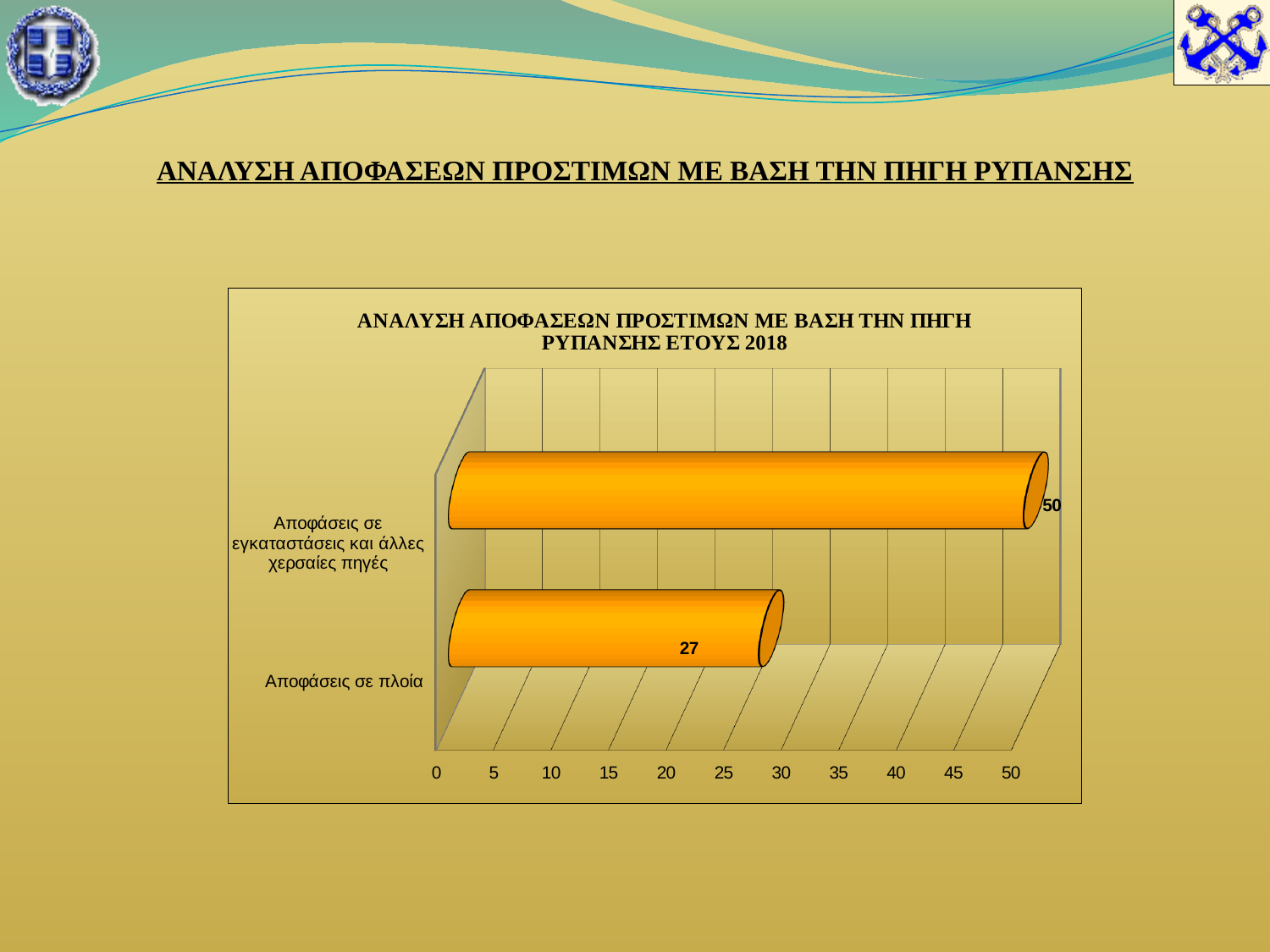
What is the title of the chart? ΑΝΑΛΥΣΗ ΑΠΟΦΑΣΕΩΝ ΠΡΟΣΤΙΜΩΝ ΜΕ ΒΑΣΗ ΤΗΝ ΠΗΓΗ ΡΥΠΑΝΣΗΣ ΕΤΟΥΣ 2018 Which category has the lowest value? Αποφάσεις σε πλοία What is the difference between the value for Αποφάσεις σε εγκαταστάσεις και άλλες χερσαίες πηγές and the value for Αποφάσεις σε πλοία? 23 Which is larger: the value for Αποφάσεις σε πλοία or the value for Αποφάσεις σε εγκαταστάσεις και άλλες χερσαίες πηγές? Αποφάσεις σε εγκαταστάσεις και άλλες χερσαίες πηγές Which category has the highest value? Αποφάσεις σε εγκαταστάσεις και άλλες χερσαίες πηγές What is the value for Αποφάσεις σε εγκαταστάσεις και άλλες χερσαίες πηγές? 50 Is the value for Αποφάσεις σε πλοία greater or less than 30? less What kind of chart is shown on the slide? bar chart How many categories are shown in the chart? 2 What is the value for Αποφάσεις σε πλοία? 27 What is the maximum value shown on the horizontal axis of the chart? 50